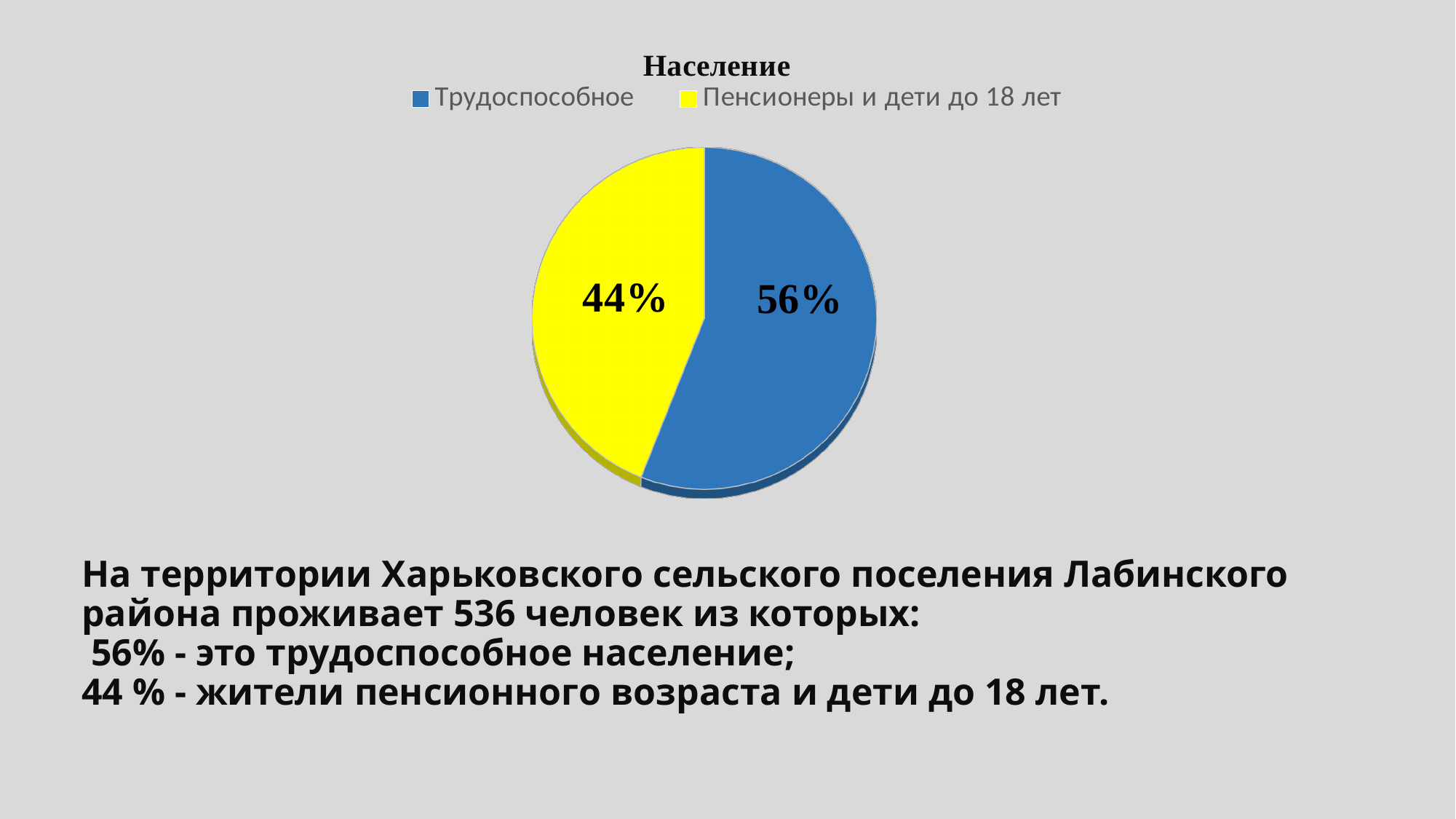
How many entries does the legend list? 2 What colour is the Пенсионеры и дети до 18 лет slice? yellow How many slices does the pie chart have? 2 Which is larger: the Трудоспособное slice or the Пенсионеры и дети до 18 лет slice? Трудоспособное What is the title of the chart? Население What kind of chart is shown on the slide? pie chart What share of the pie does Трудоспособное take? 56% What is the difference in percentage points between the Трудоспособное slice and the Пенсионеры и дети до 18 лет slice? 12 Which slice is the largest in the pie chart? Трудоспособное Is the share for Трудоспособное greater or less than 50%? greater What share of the pie does Пенсионеры и дети до 18 лет take? 44% Which slice is the smallest in the pie chart? Пенсионеры и дети до 18 лет